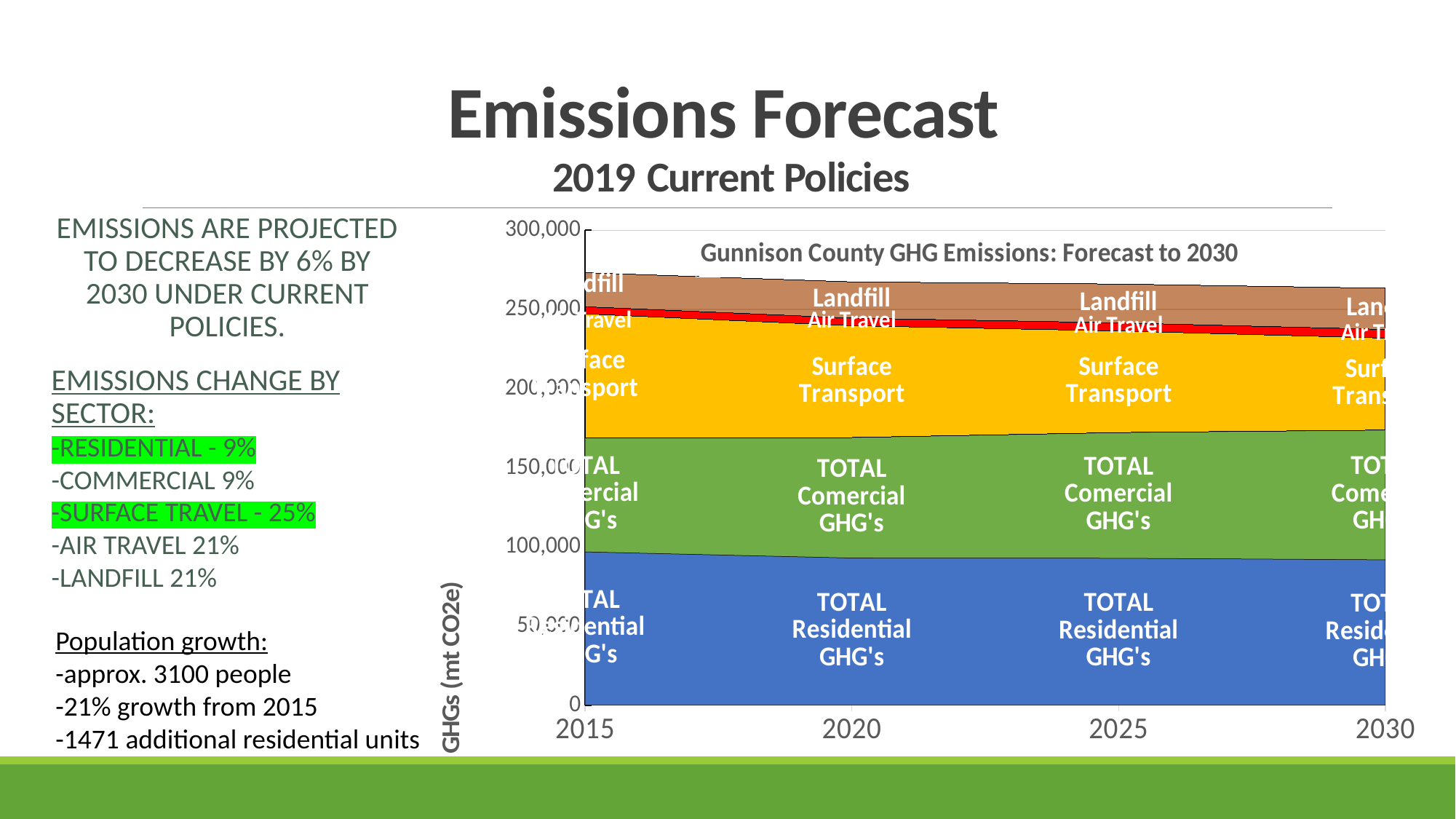
Is the total stacked emissions value in 2015 greater or less than 250,000? greater Which band is larger in 2015, TOTAL Residential GHG's or Landfill? TOTAL Residential GHG's What type of chart is shown on the slide? Stacked area chart Which sector has the thickest band in the chart? TOTAL Residential GHG's Which sector has the thinnest band in the chart? Air Travel Does the total stacked emissions value rise or fall from 2015 to 2030? Fall What is the label of the y axis? GHGs (mt CO2e) How many sectors are stacked in the chart? 5 Is the cumulative top of the TOTAL Comercial GHG's band in 2015 greater or less than 150,000? greater What is the title of the chart? Gunnison County GHG Emissions: Forecast to 2030 How many years are labelled on the x axis of the chart? 4